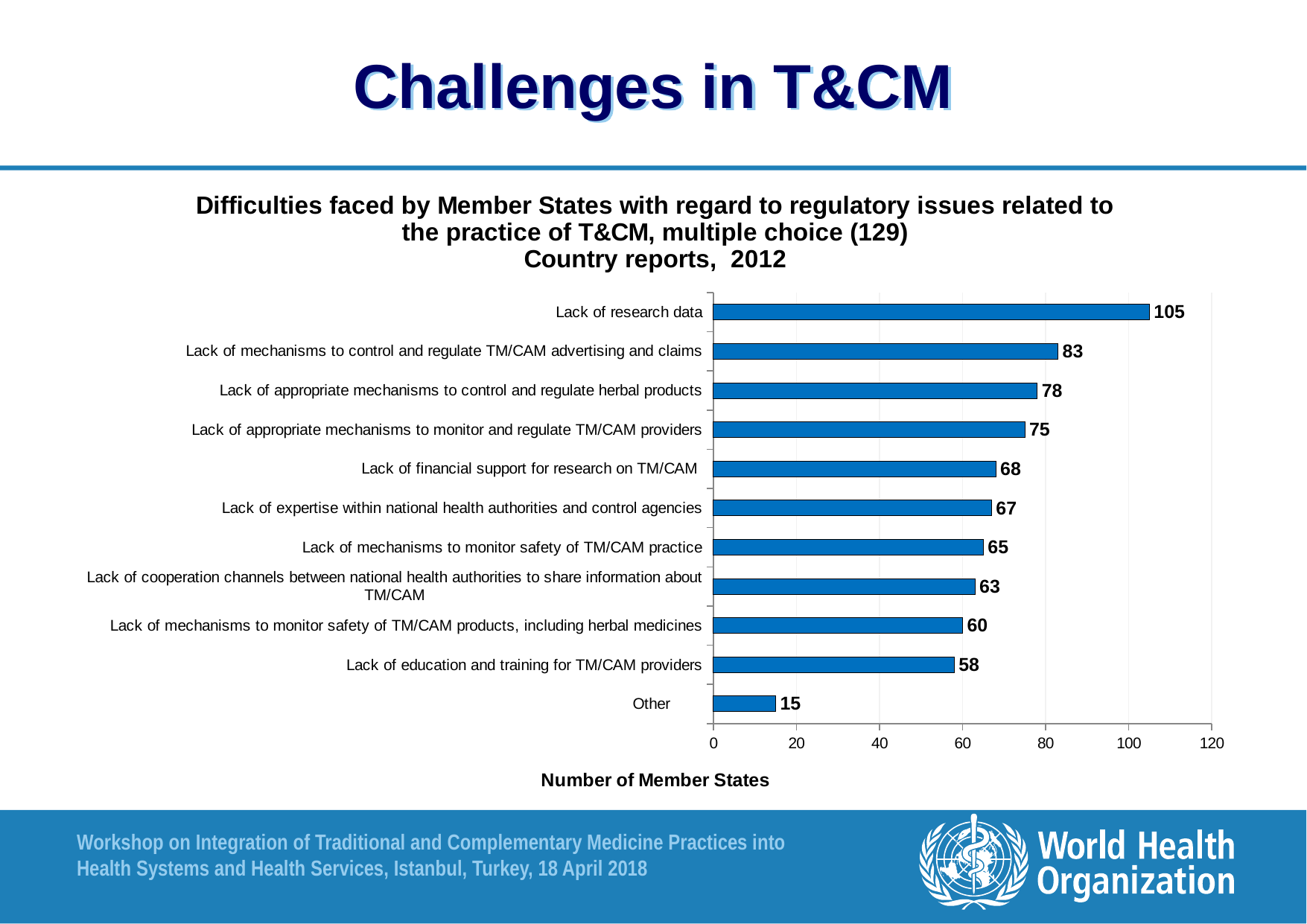
What is the value for 'Lack of financial support for research on TM/CAM'? 68 What is the difference between 'Lack of mechanisms to monitor safety of TM/CAM practice' and 'Other'? 50 What kind of chart is shown on the slide? bar chart How many categories are shown in the chart? 11 Which category has the highest number of Member States? Lack of research data What is the difference between 'Lack of research data' and 'Lack of mechanisms to control and regulate TM/CAM advertising and claims'? 22 Is the value for 'Lack of mechanisms to monitor safety of TM/CAM products, including herbal medicines' greater or less than 80? less How many Member States reported 'Lack of research data' as a difficulty? 105 What is the x-axis label of the chart? Number of Member States Which category has the lowest number of Member States? Other Which is larger: 'Lack of appropriate mechanisms to control and regulate herbal products' or 'Lack of appropriate mechanisms to monitor and regulate TM/CAM providers'? Lack of appropriate mechanisms to control and regulate herbal products What is the value for 'Lack of education and training for TM/CAM providers'? 58